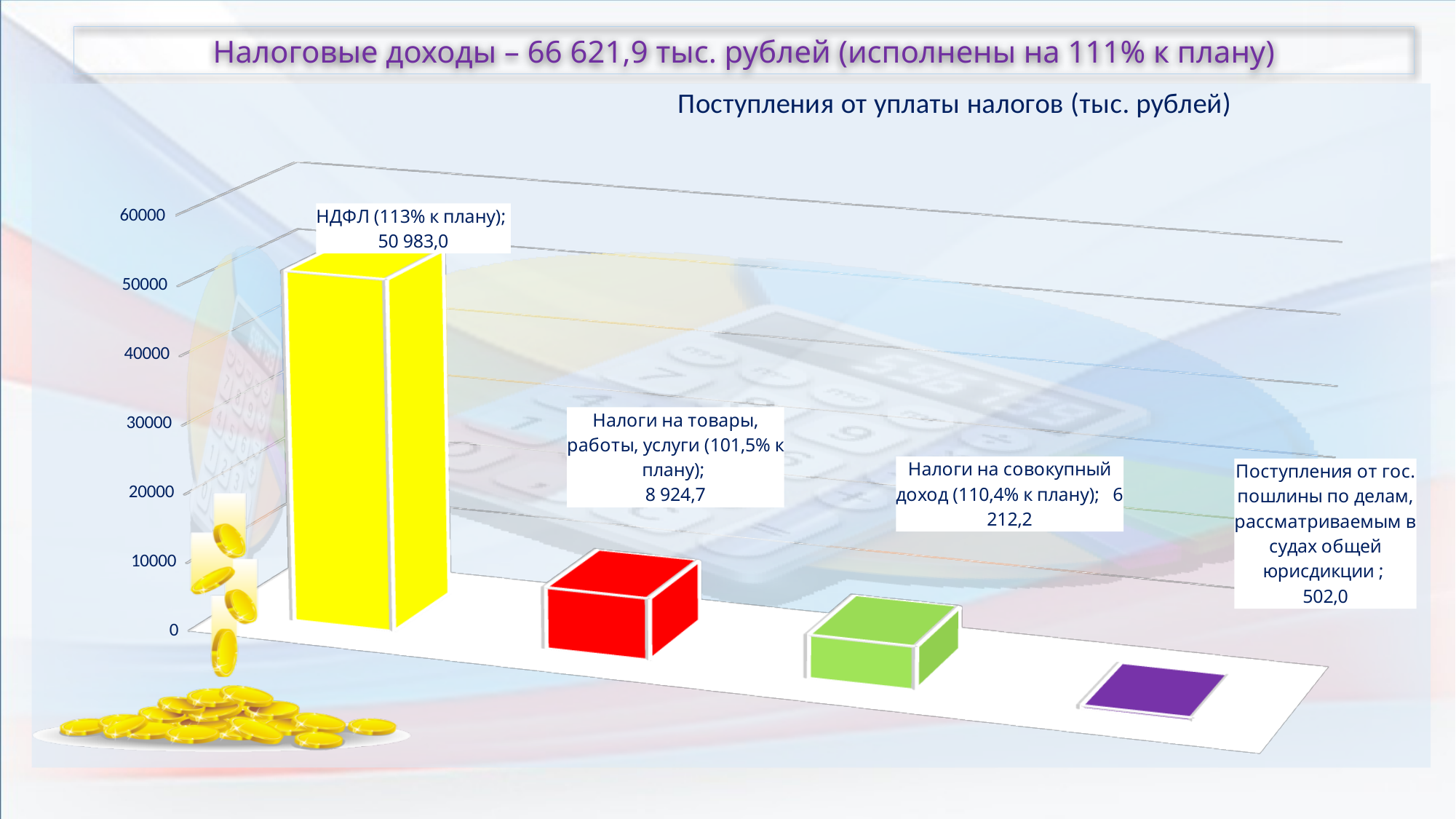
What is the difference between the values for Налоги на товары, работы, услуги and Налоги на совокупный доход? 2 712,5 What is the difference between the values for НДФЛ and Налоги на товары, работы, услуги? 42 058,3 What is the title of the chart? Поступления от уплаты налогов (тыс. рублей) What is the value for Поступления от гос. пошлины по делам, рассматриваемым в судах общей юрисдикции? 502,0 What is the value for Налоги на товары, работы, услуги? 8 924,7 What is the value for Налоги на совокупный доход? 6 212,2 What is the value for НДФЛ? 50 983,0 Is the value for НДФЛ greater or less than 40000? greater Which category has the lowest value? Поступления от гос. пошлины по делам, рассматриваемым в судах общей юрисдикции How many categories are shown in the chart? 4 Which is larger: the value for Налоги на совокупный доход or the value for Налоги на товары, работы, услуги? Налоги на товары, работы, услуги Which category has the highest value? НДФЛ